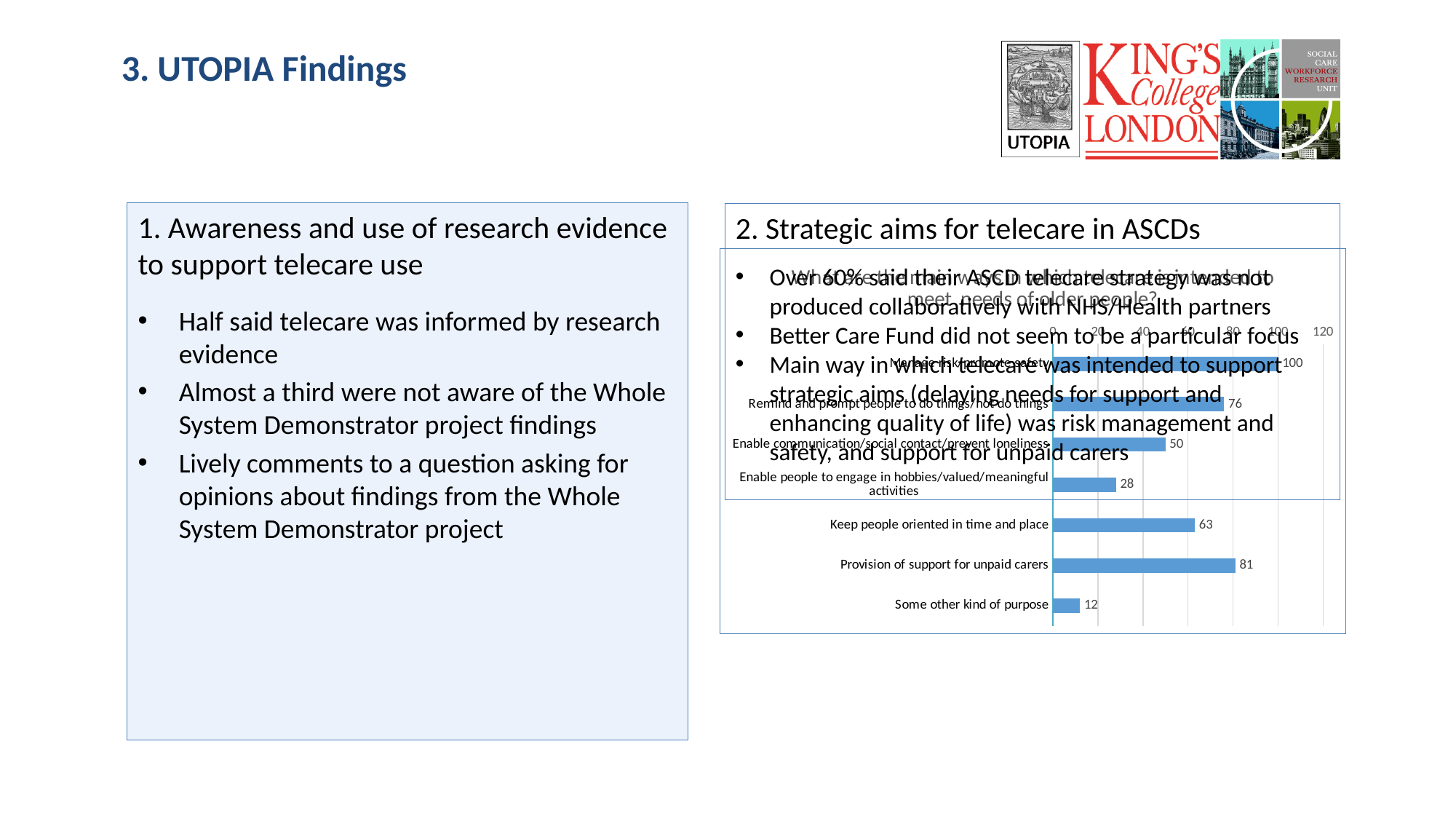
How many categories (bars) are shown in the chart? 7 What kind of chart is shown on the slide? bar chart What is the value for 'Enable communication/social contact/prevent loneliness'? 50 What is the value for 'Some other kind of purpose'? 12 What is the highest value shown in the chart? 100 What is the difference between the values for 'Provision of support for unpaid carers' and 'Keep people oriented in time and place'? 18 Which is larger: the value for 'Remind and prompt people to do things/not do things' or the value for 'Provision of support for unpaid carers'? Provision of support for unpaid carers Which category has the lowest value in the chart? Some other kind of purpose What is the value for 'Enable people to engage in hobbies/valued/meaningful activities'? 28 Is the value for 'Enable communication/social contact/prevent loneliness' greater or less than 60? less What is the value for 'Keep people oriented in time and place'? 63 What is the value for 'Provision of support for unpaid carers'? 81